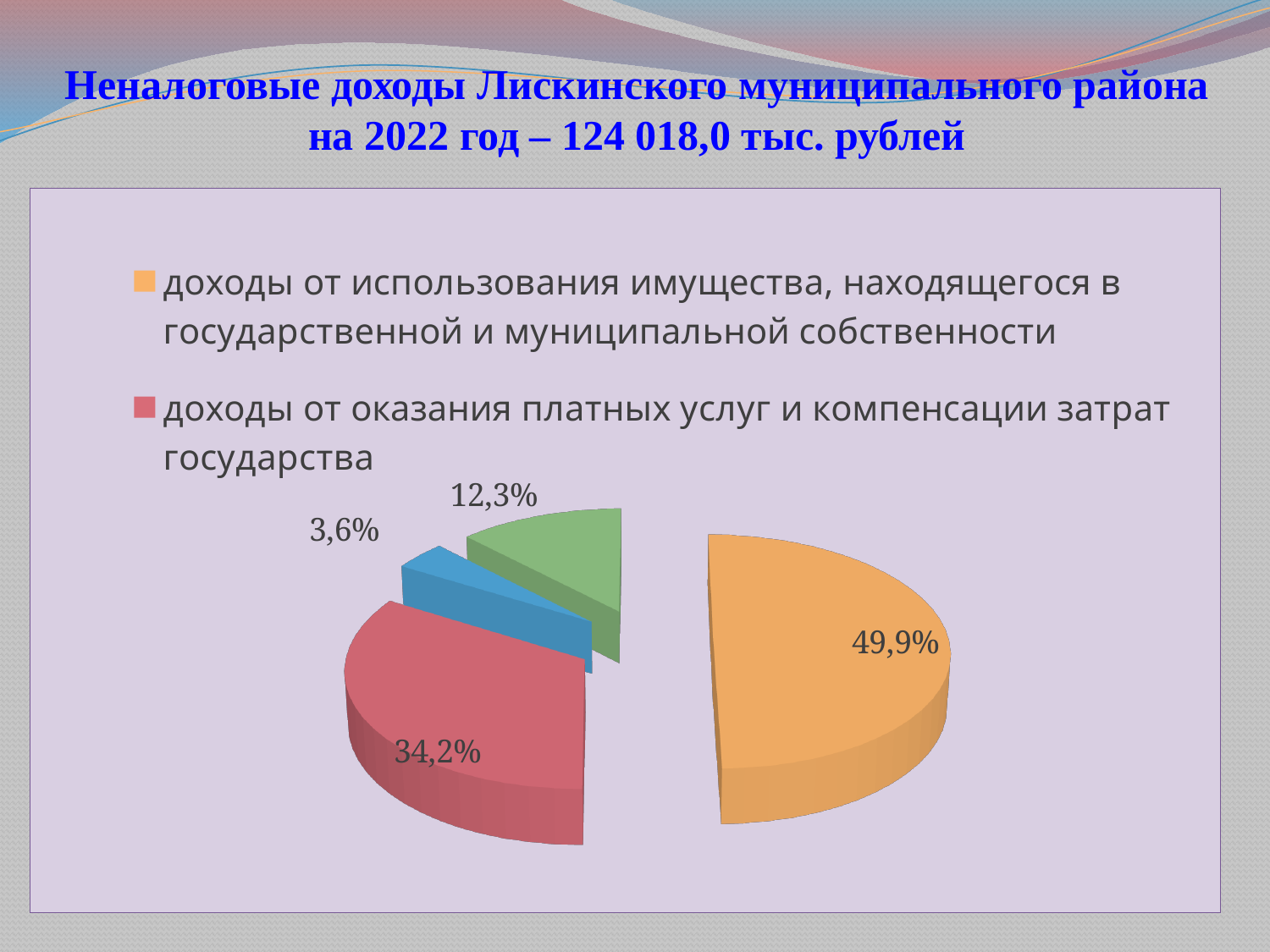
How many entries does the legend list? 2 What share of the pie is labelled for income from paid services and compensation of state costs (доходы от оказания платных услуг)? 34,2% What is the difference in percentage points between the slice for income from use of property (49,9%) and the slice for paid services (34,2%)? 15,7 What is the value of the green slice of the pie? 12,3% How many slices does the pie chart have? 4 What is the value of the largest slice in the pie chart? 49,9% What total amount of non-tax revenue for 2022 is stated in the slide title? 124 018,0 тыс. рублей What kind of chart is shown on the slide? pie chart What is the value of the smallest slice in the pie chart? 3,6% Which legend category has the largest slice of the pie? доходы от использования имущества, находящегося в государственной и муниципальной собственности Which is larger: the slice for income from use of property or the slice for paid services and compensation of state costs? доходы от использования имущества, находящегося в государственной и муниципальной собственности What share of the pie is labelled for income from the use of state and municipal property (доходы от использования имущества)? 49,9%